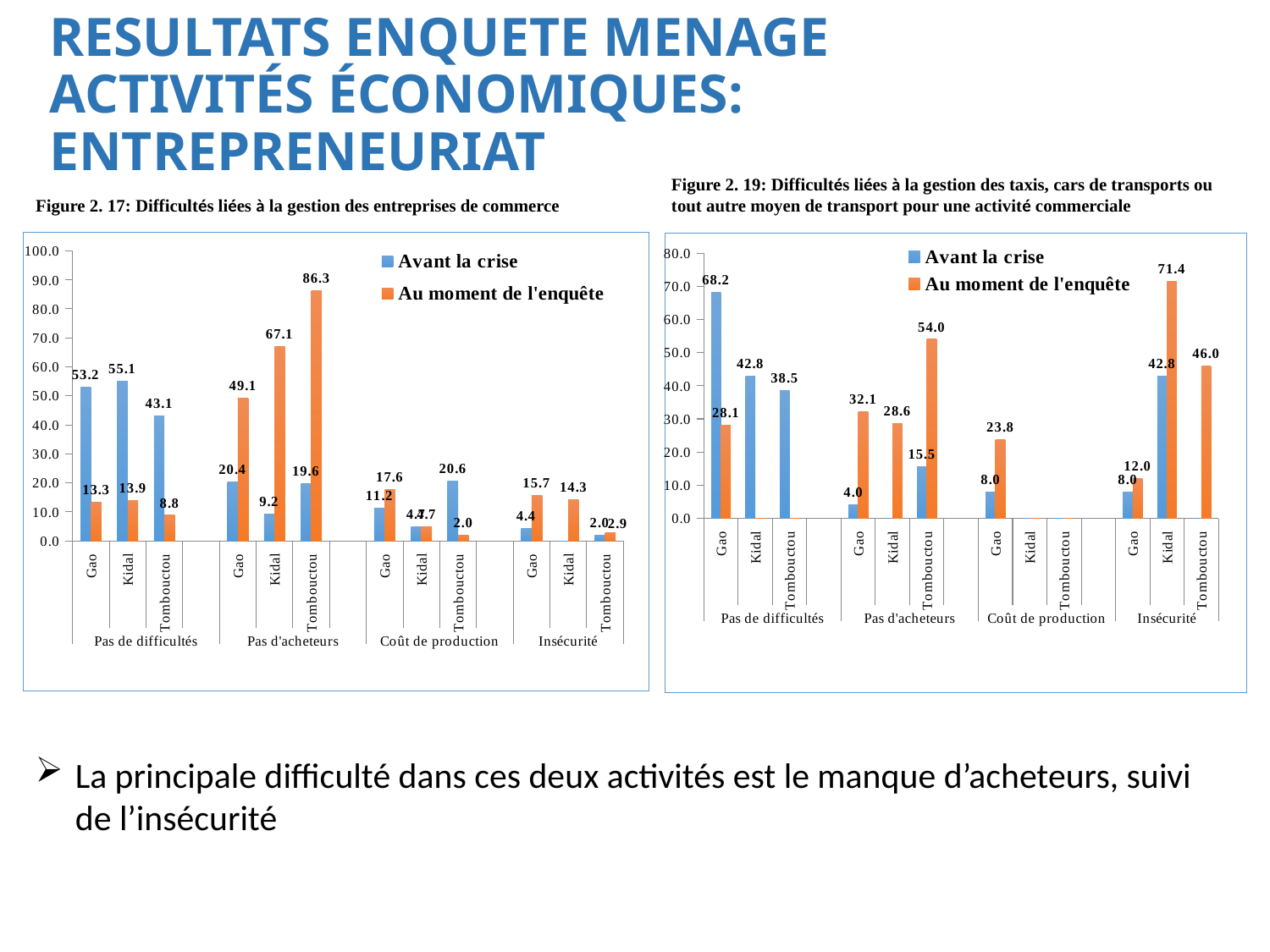
In Figure 2.19 (right chart), what is the value for Gao under 'Pas de difficultés' for the series 'Avant la crise'? 68.2 How many series does the legend list in Figure 2.17 (left chart)? 2 In Figure 2.19 (right chart), which is larger for Gao under 'Coût de production': 'Avant la crise' or 'Au moment de l'enquête'? Au moment de l'enquête In Figure 2.17 (left chart), which bar has the highest value overall? Tombouctou, Pas d'acheteurs, Au moment de l'enquête (86.3) In Figure 2.17 (left chart), what is the difference between the 'Avant la crise' and 'Au moment de l'enquête' values for Gao under 'Pas de difficultés'? 39.9 In Figure 2.17 (left chart), what is the value for Tombouctou under 'Pas d'acheteurs' for the series 'Au moment de l'enquête'? 86.3 In Figure 2.17 (left chart), what is the value for Kidal under 'Pas de difficultés' for the series 'Avant la crise'? 55.1 In Figure 2.19 (right chart), what is the value for Kidal under 'Insécurité' for the series 'Au moment de l'enquête'? 71.4 What type of chart is Figure 2.19 (right chart)? Bar chart In Figure 2.19 (right chart), what is the difference between the 'Au moment de l'enquête' and 'Avant la crise' values for Tombouctou under 'Pas d'acheteurs'? 38.5 How many difficulty categories are shown along the x axis of Figure 2.19 (right chart)? 4 In Figure 2.17 (left chart), which is larger for Kidal under 'Pas d'acheteurs': 'Avant la crise' or 'Au moment de l'enquête'? Au moment de l'enquête